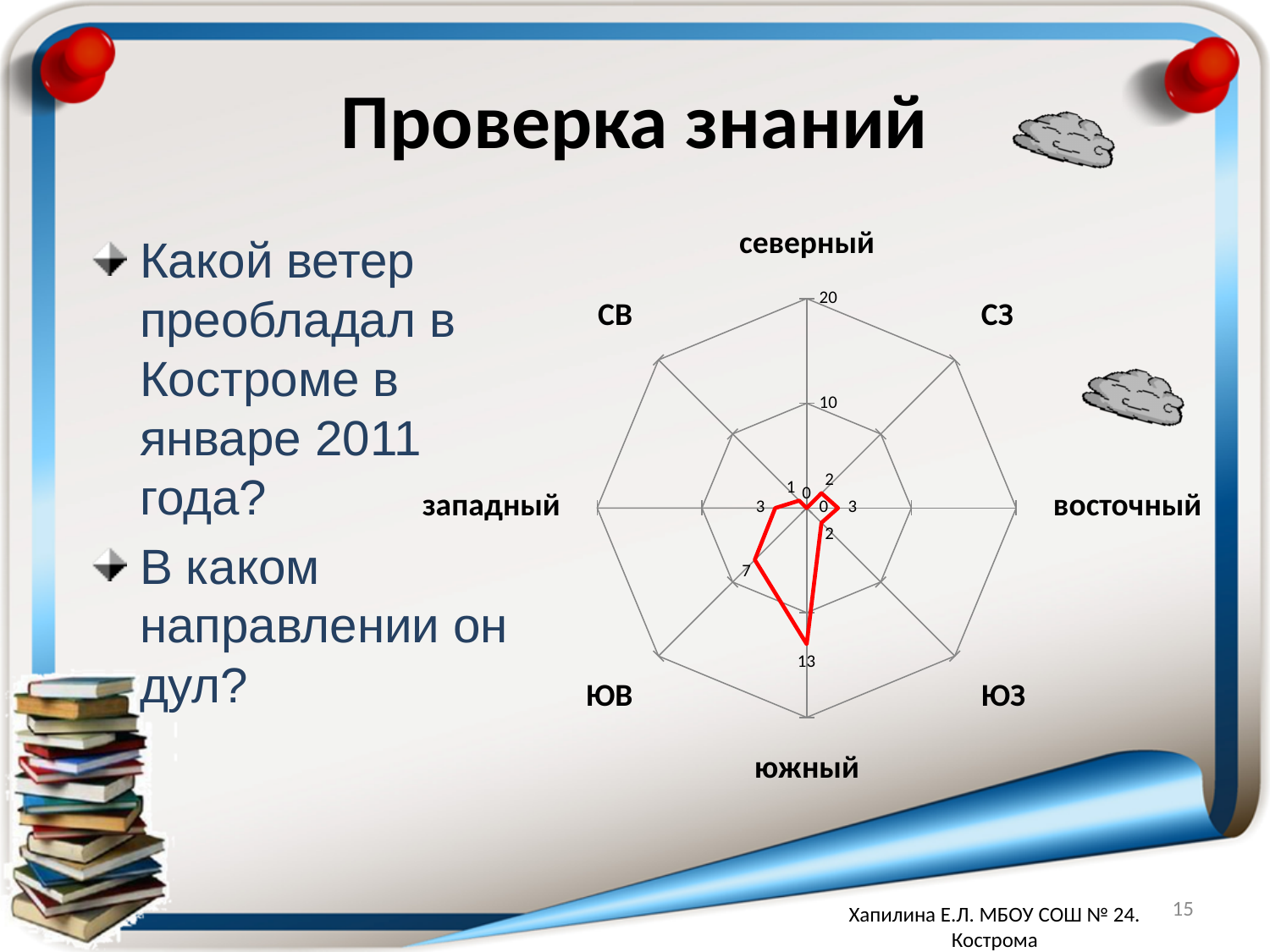
What is the value for восточный on the radar chart? 3 How many wind directions are plotted on the chart? 8 Which direction has the lowest value on the radar chart? северный Is the value for южный greater or less than 10? greater What is the value for южный on the radar chart? 13 Which direction has the highest value on the radar chart? южный Which has a larger value, ЮВ or западный? ЮВ What is the difference between the values for южный and ЮВ? 6 What is the value for СЗ on the radar chart? 2 What is the value for СВ on the radar chart? 1 What is the value for ЮВ on the radar chart? 7 What kind of chart is shown on the slide? radar chart